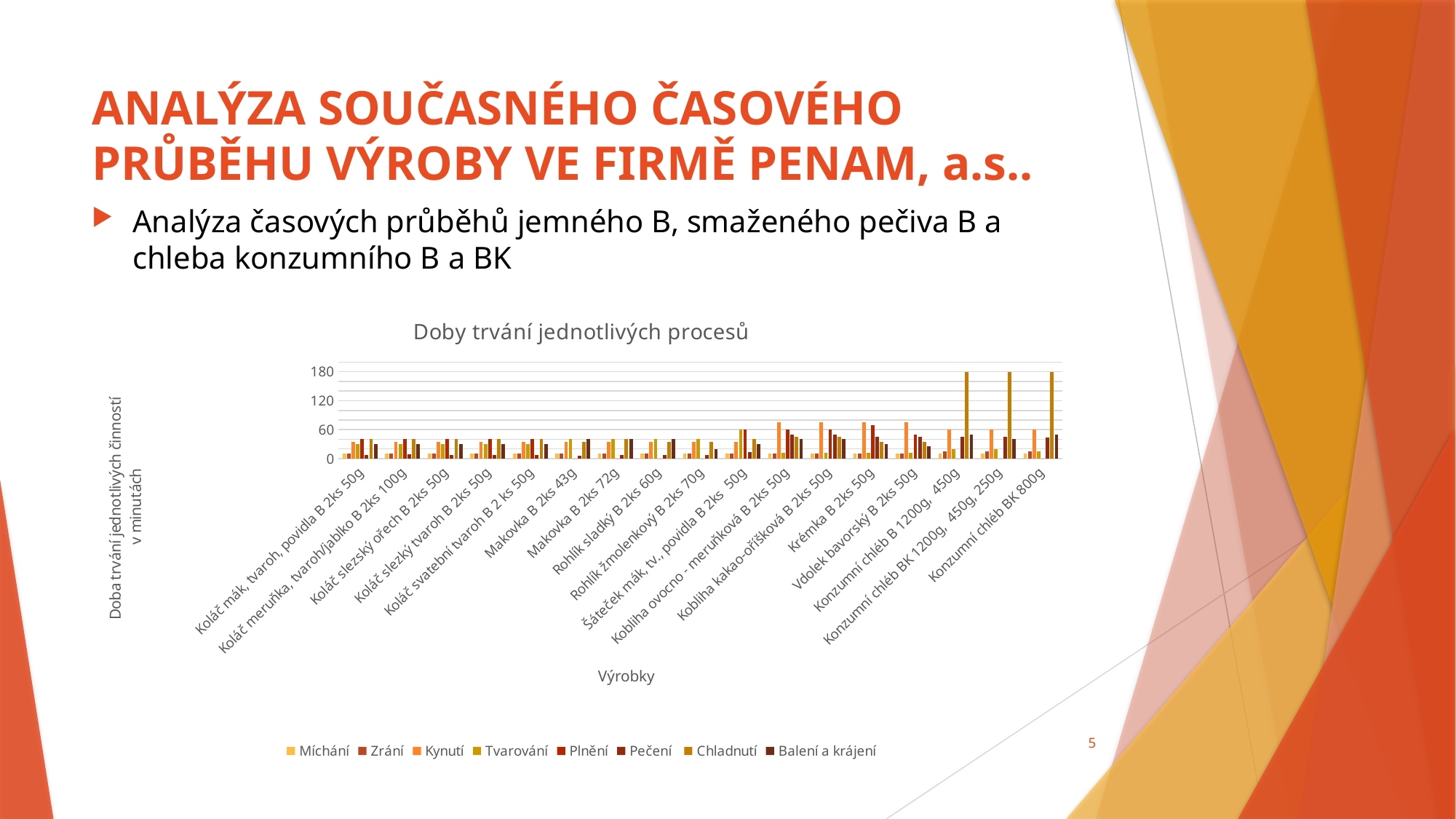
How many product categories are shown on the x axis of the chart? 17 Is the Chladnutí value for Konzumní chléb BK 800g greater or less than 120? greater For Konzumní chléb BK 1200g, 450g, 250g, which is larger: the Chladnutí value or the Míchání value? Chladnutí What kind of chart is shown on the slide? bar chart How many series does the chart legend list? 8 Which is larger: the Kynutí value for Krémka B 2ks 50g or the Kynutí value for Makovka B 2ks 43g? Krémka B 2ks 50g Is the Míchání value for Makovka B 2ks 43g greater or less than 60? less What is the title of the chart? Doby trvání jednotlivých procesů What is the label of the x axis of the chart? Výrobky Which series has the tallest bars in the chart? Chladnutí Is the Chladnutí value for Konzumní chléb B 1200g, 450g greater or less than 120? greater